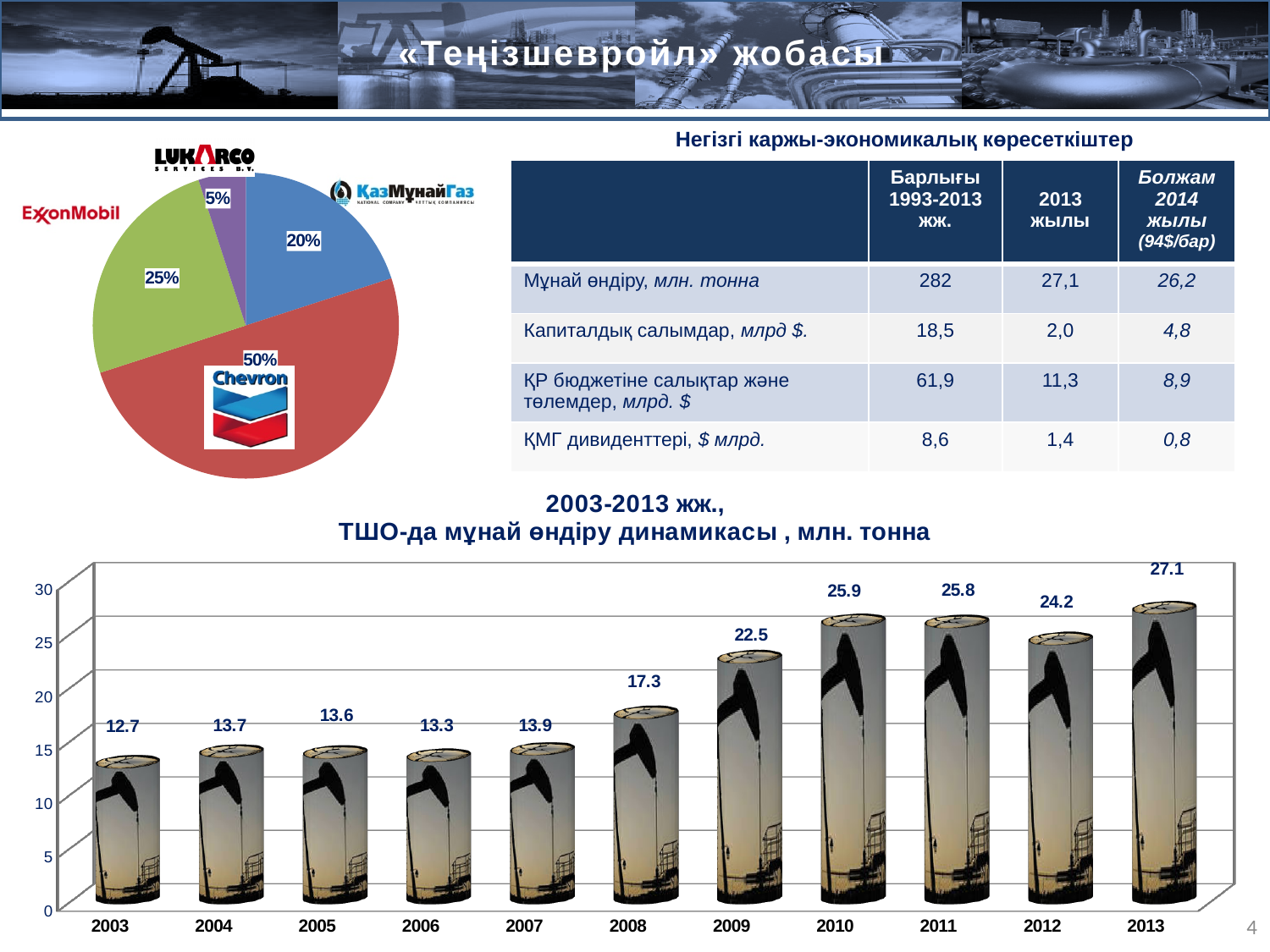
In the bar chart at the bottom of the slide, what is the difference between the values for 2013 and 2003? 14.4 What kind of chart is shown at the bottom of the slide? Bar chart In the pie chart at the top left of the slide, what share is labelled next to the LukArco logo? 5% In the bar chart at the bottom of the slide, which year has the lowest value? 2003 How many slices does the pie chart at the top left of the slide have? 4 In the bar chart at the bottom of the slide, what is the value for 2013? 27.1 In the bar chart at the bottom of the slide, which is larger, the value for 2010 or the value for 2012? 2010 In the bar chart at the bottom of the slide, how many years are shown on the x axis? 11 In the bar chart at the bottom of the slide, what is the value for 2008? 17.3 In the pie chart at the top left of the slide, what share is labelled next to the Chevron logo? 50% In the bar chart at the bottom of the slide, do the values generally rise or fall from 2007 to 2010? Rise In the bar chart at the bottom of the slide, which year has the highest value? 2013